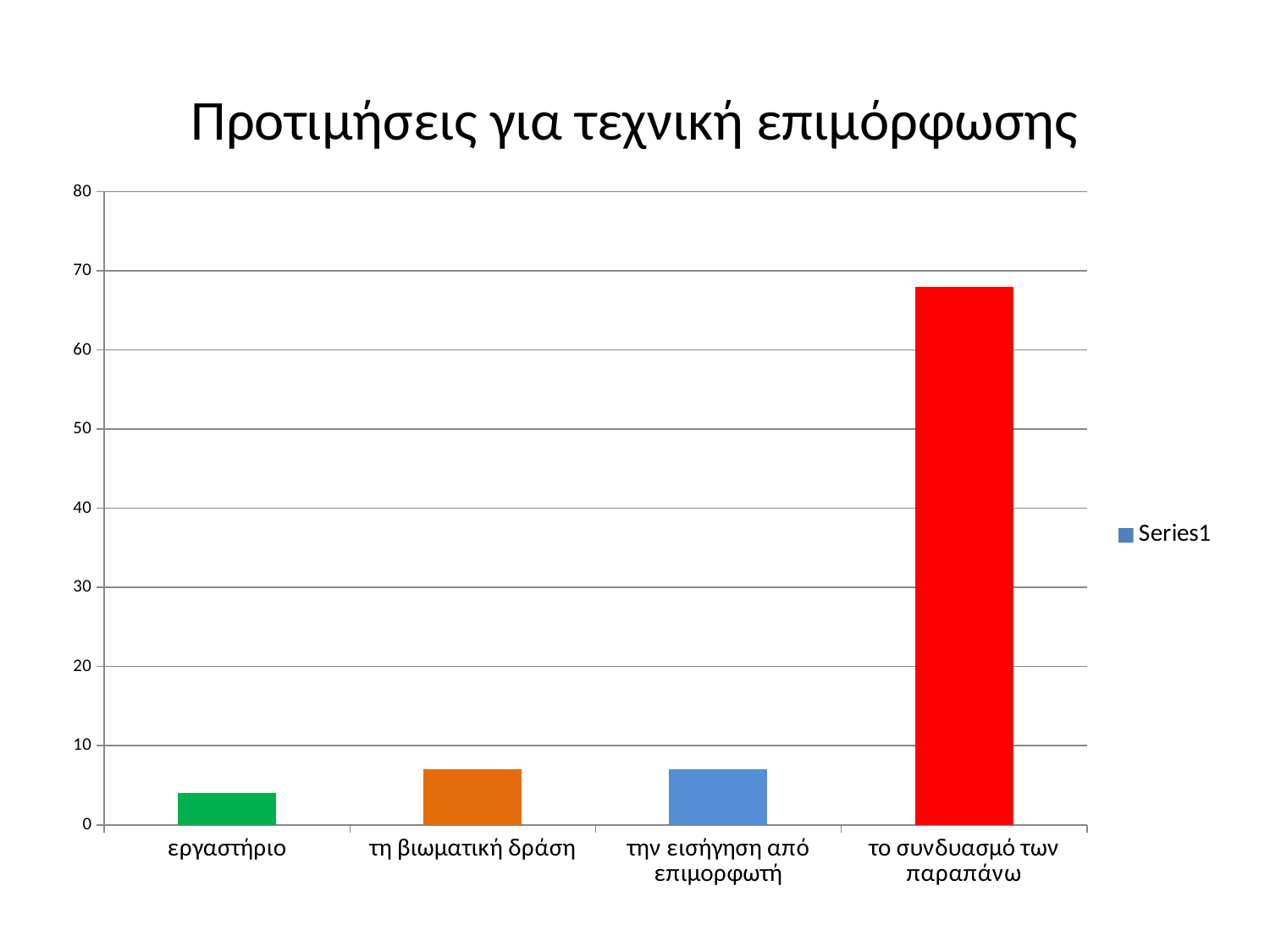
Which is larger, the value for εργαστήριο or the value for τη βιωματική δράση? τη βιωματική δράση What is the title of the chart? Προτιμήσεις για τεχνική επιμόρφωσης How many series does the legend list? 1 How many categories are shown on the x axis of the chart? 4 Is the value for το συνδυασμό των παραπάνω greater or less than 70? less Which category has the lowest value? εργαστήριο Is the value for το συνδυασμό των παραπάνω greater or less than 60? greater What kind of chart is shown on the slide? bar chart Is the value for τη βιωματική δράση greater or less than 10? less Which category has the highest value? το συνδυασμό των παραπάνω What colour is the bar for το συνδυασμό των παραπάνω? red